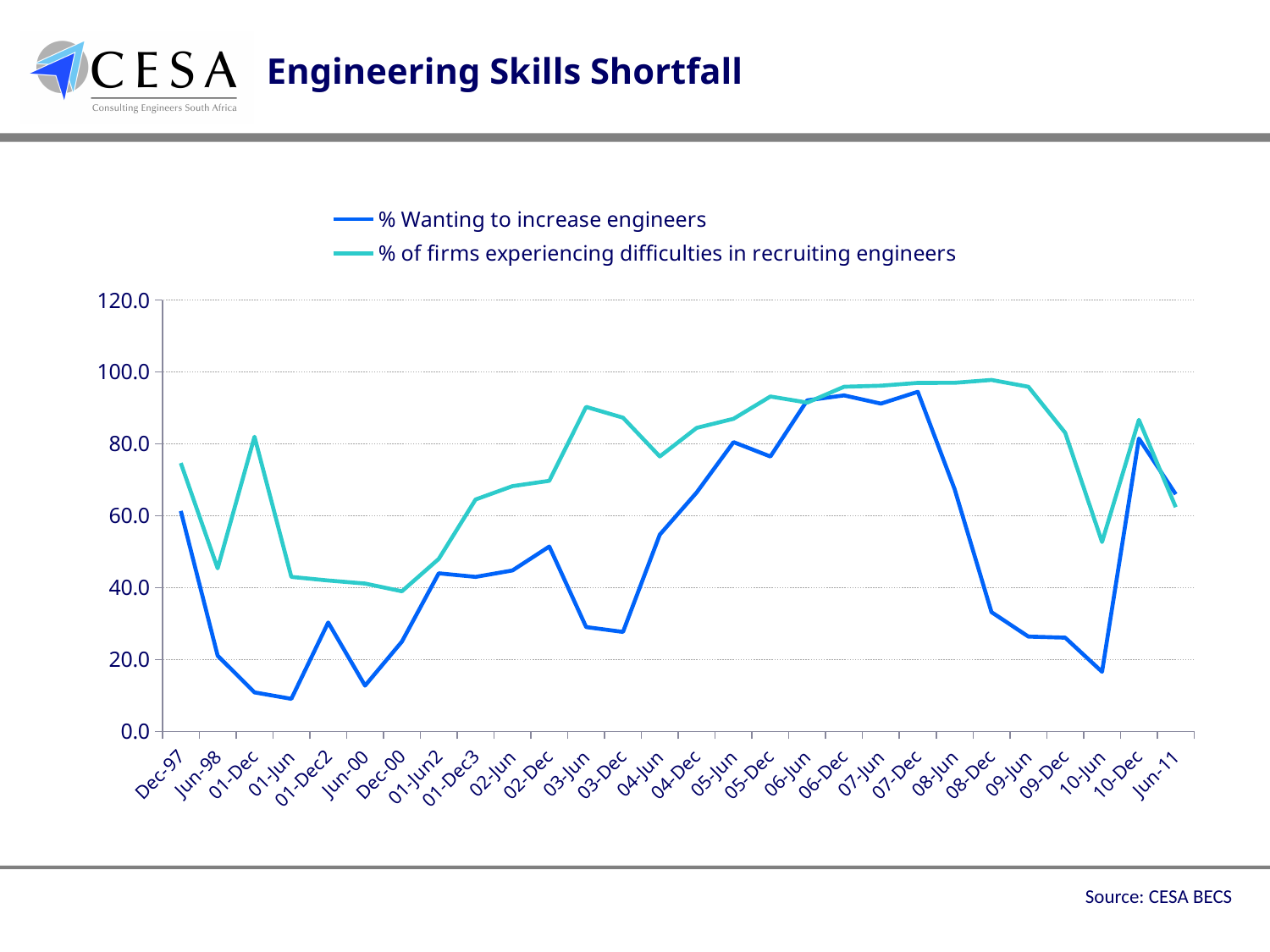
Does the '% Wanting to increase engineers' series rise or fall between 07-Dec and 10-Jun? fall Is the value for '% of firms experiencing difficulties in recruiting engineers' at 10-Jun greater or less than 60.0? less Is the value for '% of firms experiencing difficulties in recruiting engineers' at 03-Jun greater or less than 80.0? greater Does the '% of firms experiencing difficulties in recruiting engineers' series rise or fall between Dec-00 and 03-Jun? rise What kind of chart is shown on the slide? line chart How many time points are shown along the x axis? 28 Is the value for '% Wanting to increase engineers' at 01-Jun greater or less than 20.0? less At Dec-97, which series has the higher value: '% Wanting to increase engineers' or '% of firms experiencing difficulties in recruiting engineers'? % of firms experiencing difficulties in recruiting engineers At 08-Dec, which series has the lower value: '% Wanting to increase engineers' or '% of firms experiencing difficulties in recruiting engineers'? % Wanting to increase engineers What is the title of the slide containing the chart? Engineering Skills Shortfall How many series does the legend list? 2